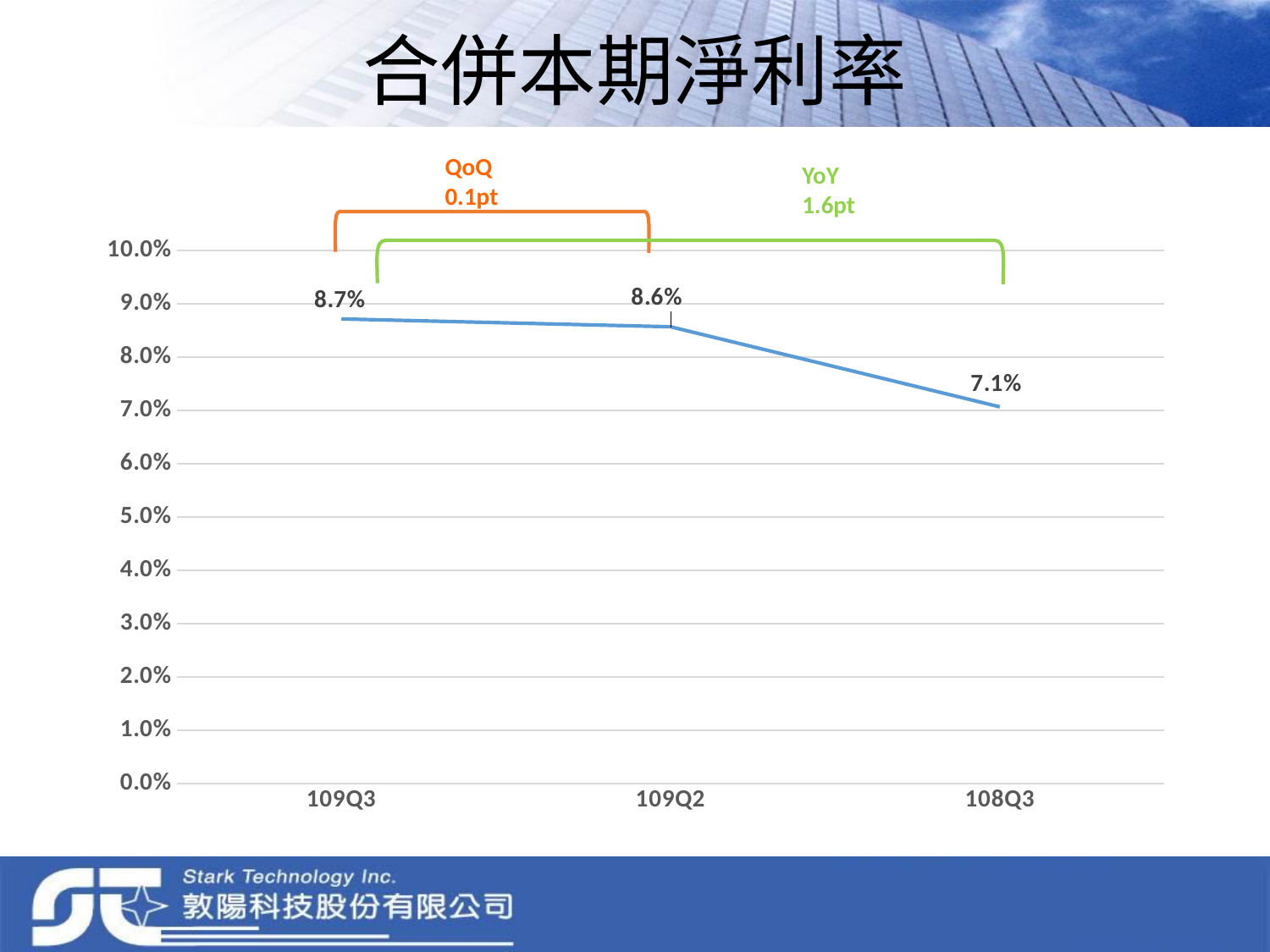
How many categories are shown on the x axis? 3 What is the difference between the values for 109Q3 and 109Q2? 0.1% Which category has the lowest value? 108Q3 What is the title of the slide? 合併本期淨利率 Which category has the highest value? 109Q3 What is the value for 109Q2? 8.6% Is the value for 108Q3 greater or less than 8.0%? less What kind of chart is shown on the slide? line chart What is the difference between the values for 109Q3 and 108Q3? 1.6% What is the value for 108Q3? 7.1% Which is larger, the value for 109Q2 or the value for 108Q3? 109Q2 What is the value for 109Q3? 8.7%